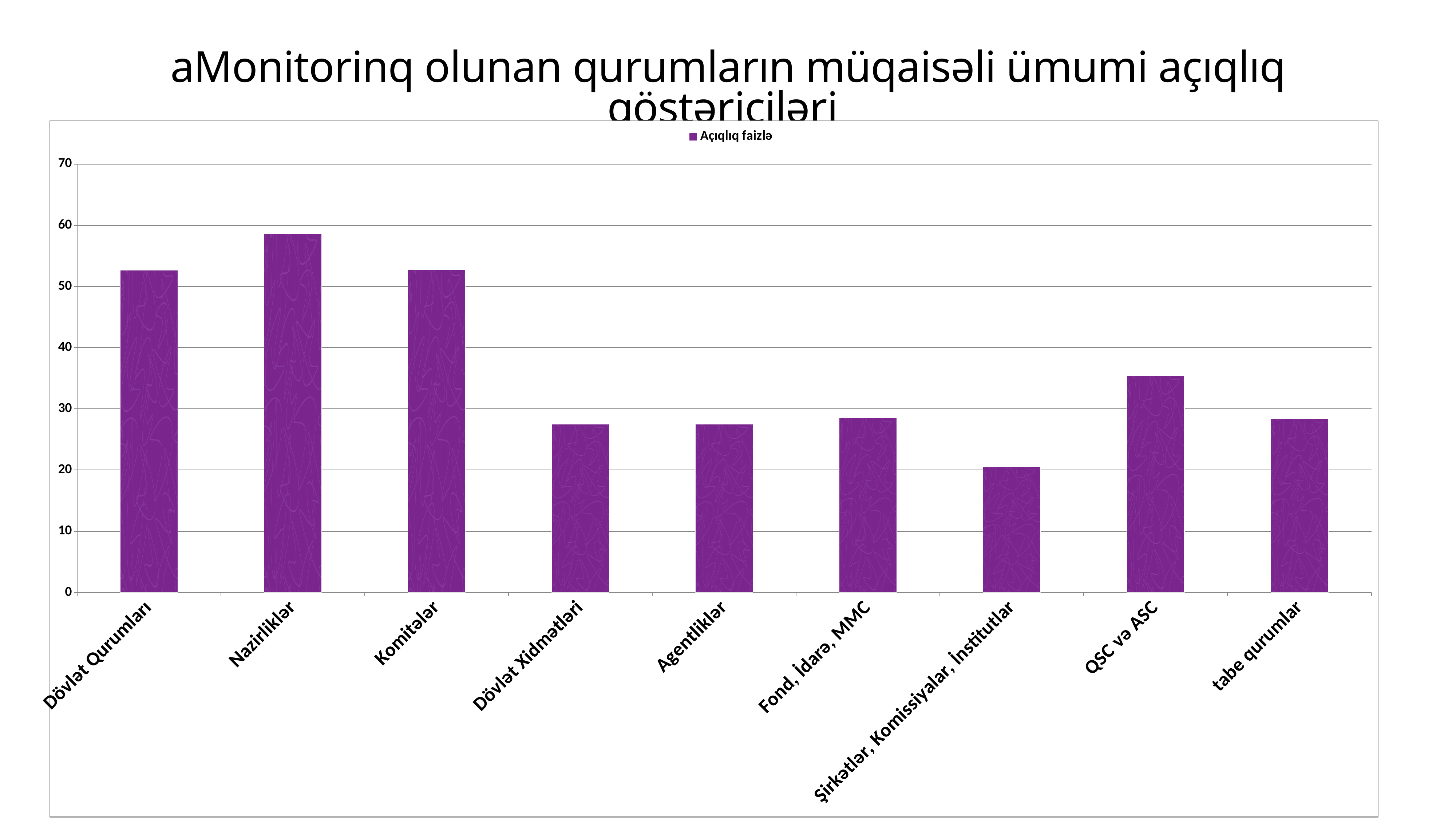
Which is larger, the value for Nazirliklər or the value for QSC və ASC? Nazirliklər Is the value for QSC və ASC greater or less than 30? greater What is the name of the series shown in the legend? Açıqlıq faizlə Is the value for Nazirliklər greater or less than 60? less How many series does the legend list? 1 Which category has the lowest value? Şirkətlər, Komissiyalar, İnstitutlar Is the value for Dövlət Xidmətləri greater or less than 30? less What kind of chart is shown on the slide? bar chart How many categories are plotted on the x axis? 9 Which category has the highest value? Nazirliklər Which is larger, the value for Dövlət Xidmətləri or the value for Dövlət Qurumları? Dövlət Qurumları